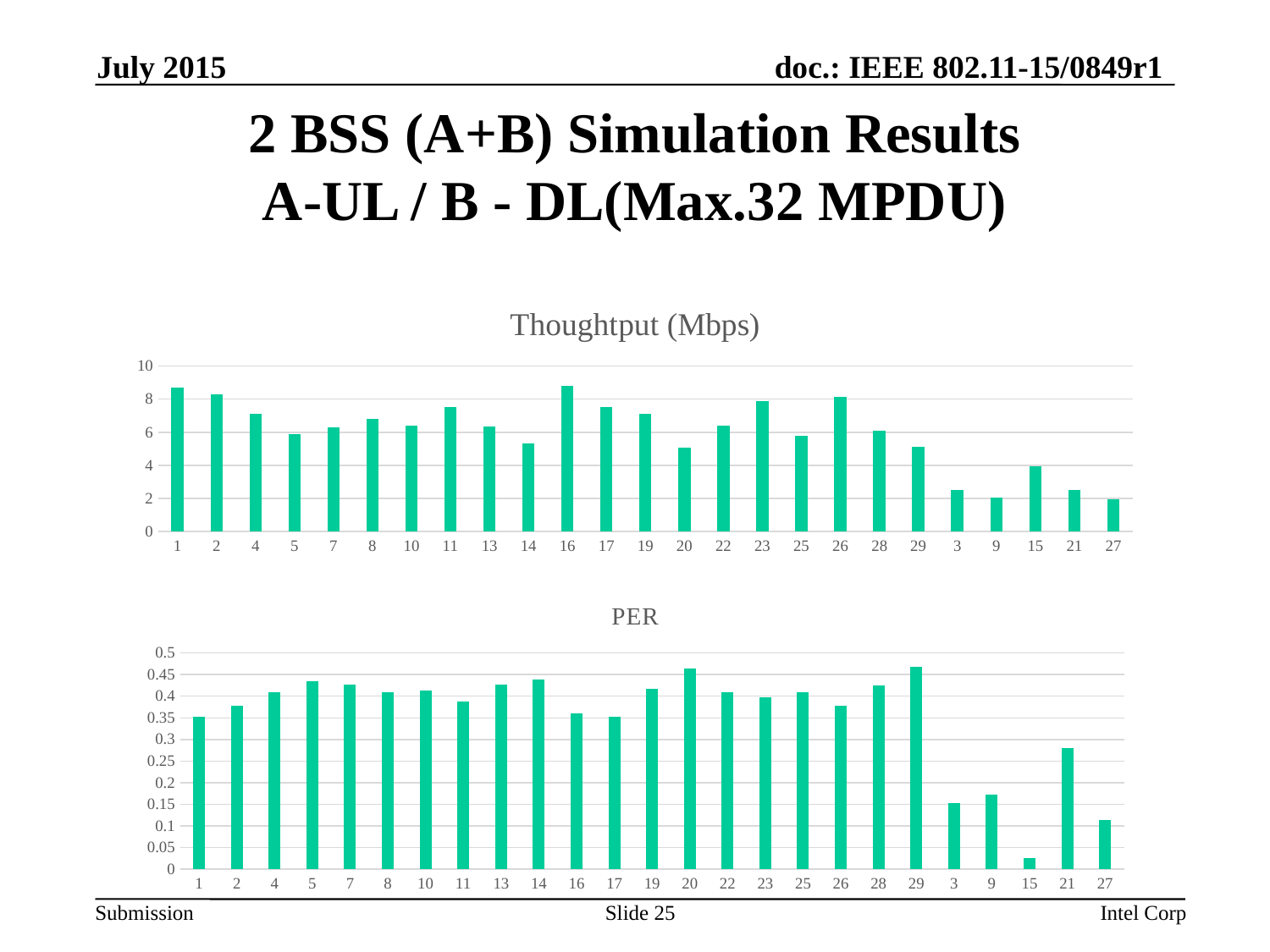
On the Thoughtput (Mbps) chart, which is larger, the value for category 14 or the value for category 16? category 16 On the PER chart, which category has the lowest value? 15 On the PER chart, is the value for category 20 greater or less than 0.45? greater How many categories are plotted on the PER chart? 25 What is the title of the upper chart on the slide? Thoughtput (Mbps) On the PER chart, is the value for category 3 greater or less than 0.2? less What kind of chart is the Thoughtput (Mbps) chart? bar chart On the Thoughtput (Mbps) chart, is the value for category 1 greater or less than 8? greater On the PER chart, which is larger, the value for category 21 or the value for category 27? category 21 On the Thoughtput (Mbps) chart, which is larger, the value for category 1 or the value for category 3? category 1